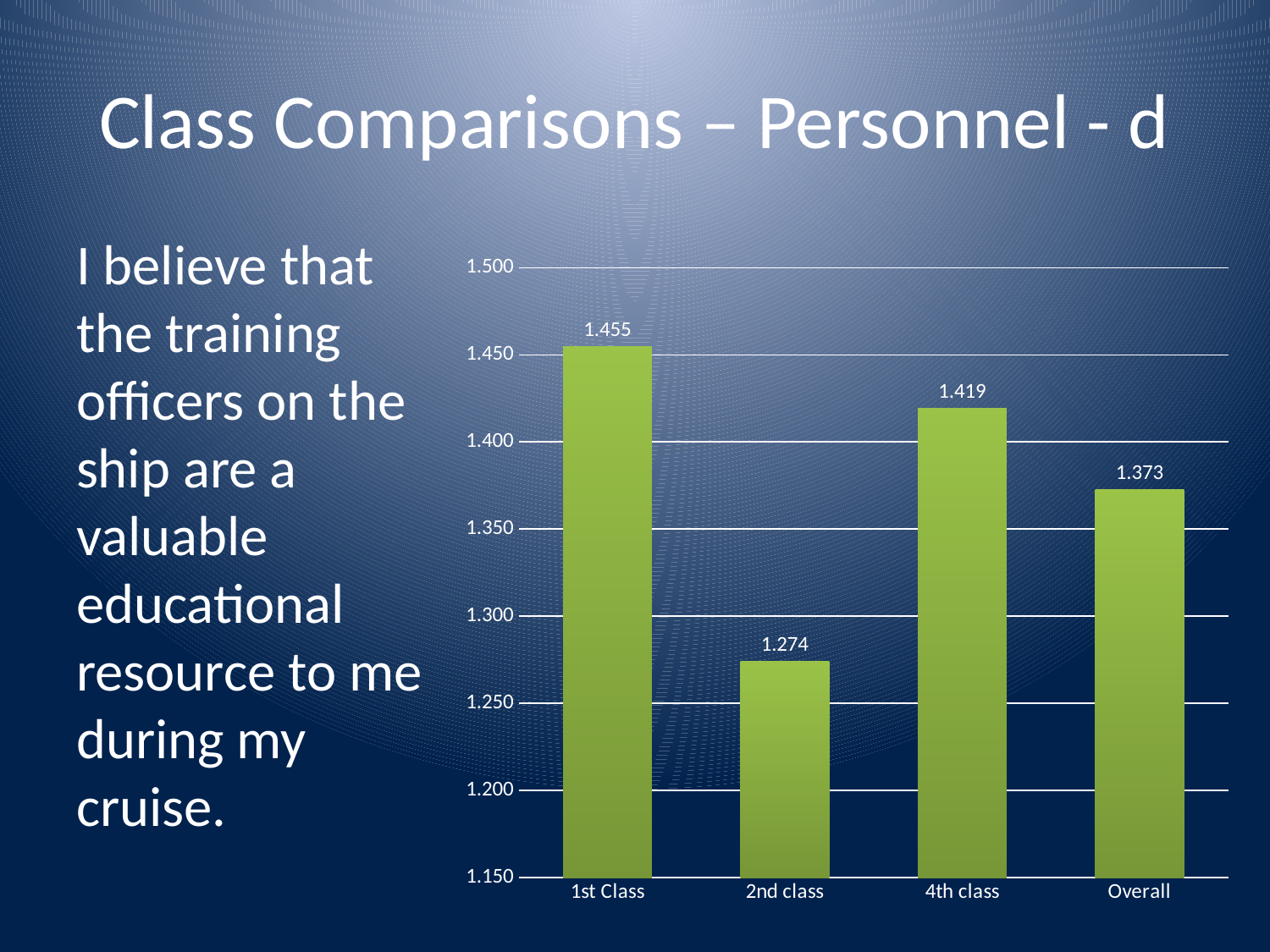
What is the value for 2nd class? 1.274 What is the value for 4th class? 1.419 Which category has the highest value? 1st Class What is the difference between the values for 4th class and Overall? 0.046 What kind of chart is shown on the slide? bar chart Which category has the lowest value? 2nd class Which is larger, the value for 4th class or the value for Overall? 4th class What is the value for 1st Class? 1.455 Is the value for 2nd class greater or less than 1.300? less What is the value for Overall? 1.373 How many categories are shown on the x axis? 4 What is the difference between the values for 1st Class and 2nd class? 0.181